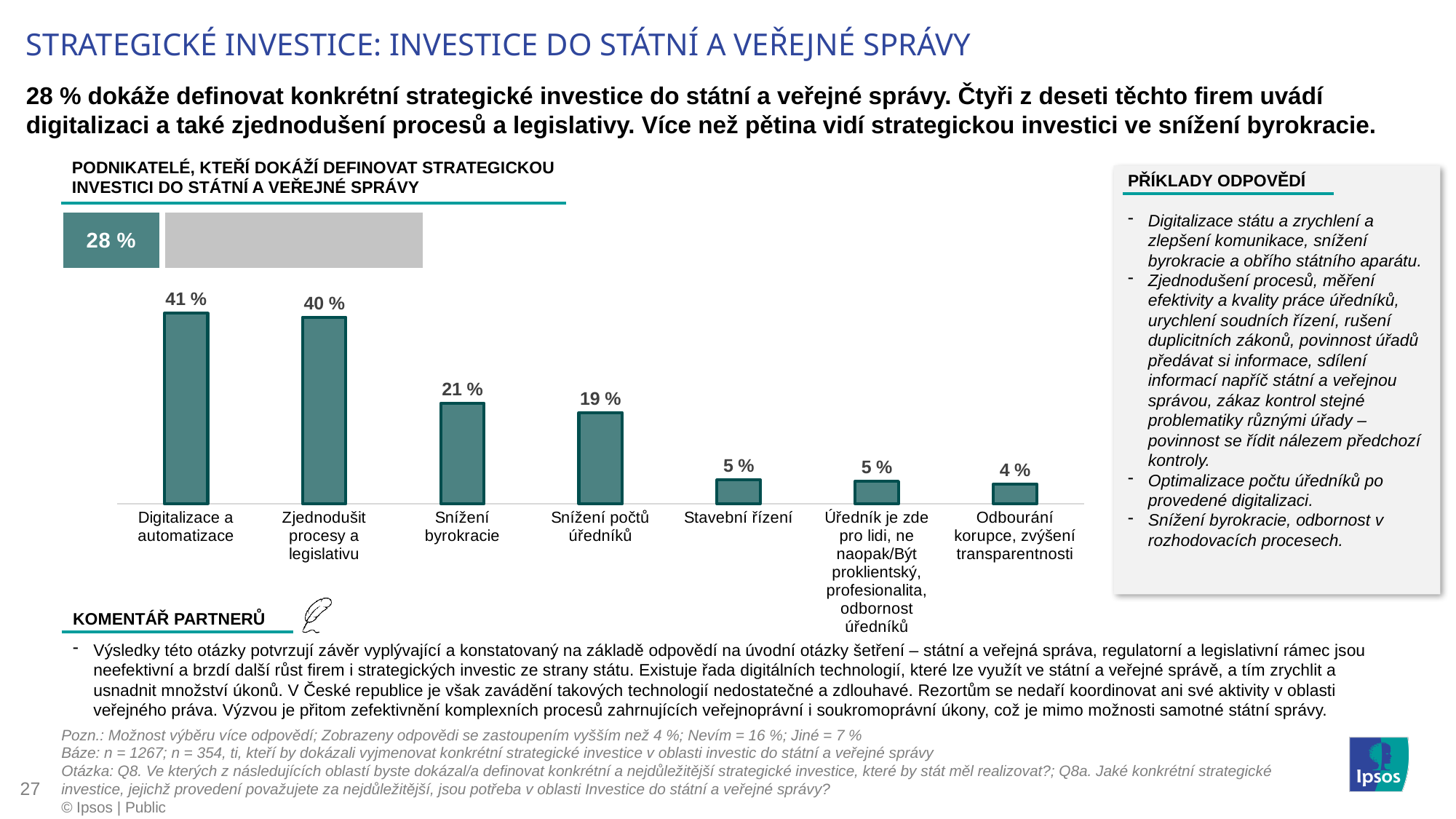
What is the value for Snížení počtů úředníků in the bar chart? 19 % What is the value for Digitalizace a automatizace in the bar chart? 41 % Which category has the lowest value in the bar chart? Odbourání korupce, zvýšení transparentnosti What is the value for Snížení byrokracie in the bar chart? 21 % Which is larger, the value for Snížení byrokracie or the value for Stavební řízení? Snížení byrokracie How many categories are shown in the bar chart? 7 What is the value for Odbourání korupce, zvýšení transparentnosti in the bar chart? 4 % What is the difference between the values for Digitalizace a automatizace and Snížení byrokracie? 20 % Which category has the highest value in the bar chart? Digitalizace a automatizace What is the difference between the values for Zjednodušit procesy a legislativu and Snížení počtů úředníků? 21 % What share of entrepreneurs can define a strategic investment in state and public administration, according to the small bar above the chart? 28 % What kind of chart is used to show the categories of strategic investments? Bar chart